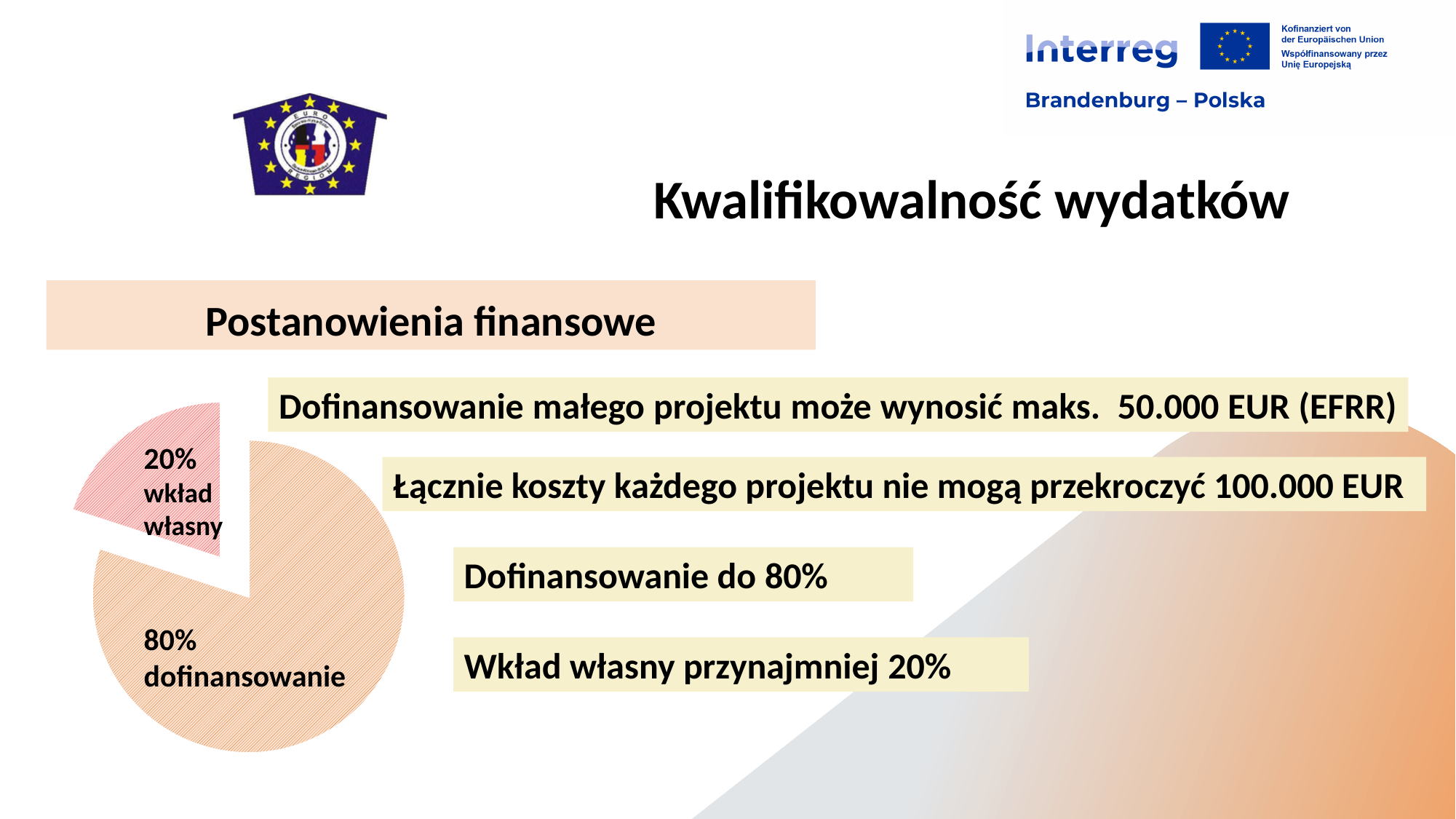
Which slice of the pie chart is the largest? 80% dofinansowanie What share of the pie is labelled "dofinansowanie"? 80% Which is larger in the pie chart, dofinansowanie or wkład własny? dofinansowanie Is the share for dofinansowanie greater or less than 50%? greater How many slices does the pie chart have? 2 What share of the pie is labelled "wkład własny"? 20% What is the heading of the section containing the pie chart? Postanowienia finansowe What is the difference in percentage points between the dofinansowanie slice and the wkład własny slice? 60% Is the share for wkład własny greater or less than 50%? less Which slice of the pie chart is pulled out (exploded) from the rest? 20% wkład własny Which slice of the pie chart is the smallest? 20% wkład własny What kind of chart is shown on the slide? pie chart